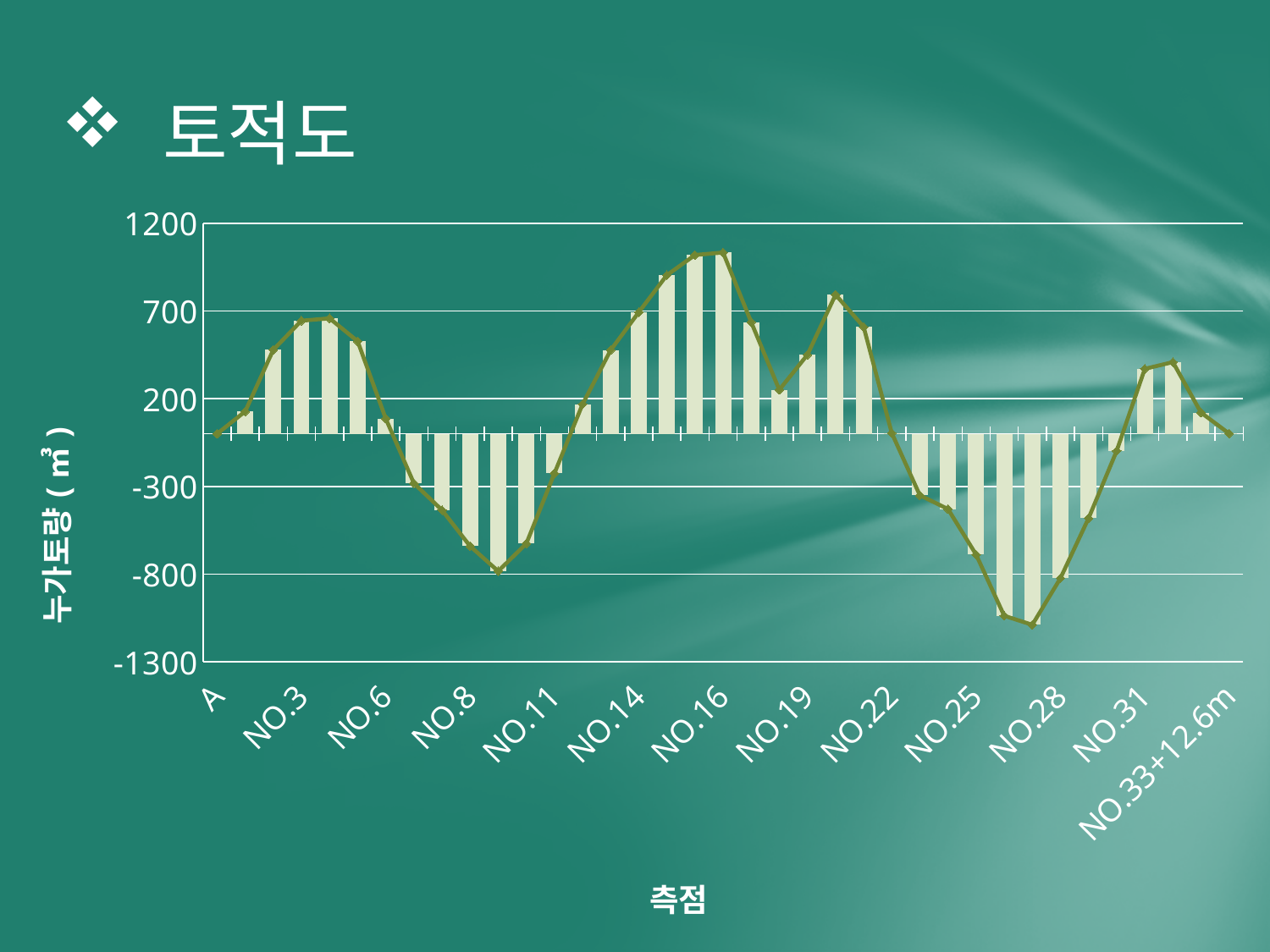
How many category labels are shown along the x axis? 13 What kind of chart is shown on the slide? bar chart with a line Is the lowest point on the chart greater or less than -800? less Is the value at NO.33+12.6m greater or less than 200? less What is the label on the vertical axis of the chart? 누가토량 (㎥) Is the highest point on the chart greater or less than 700? greater What is the title of the chart? 토적도